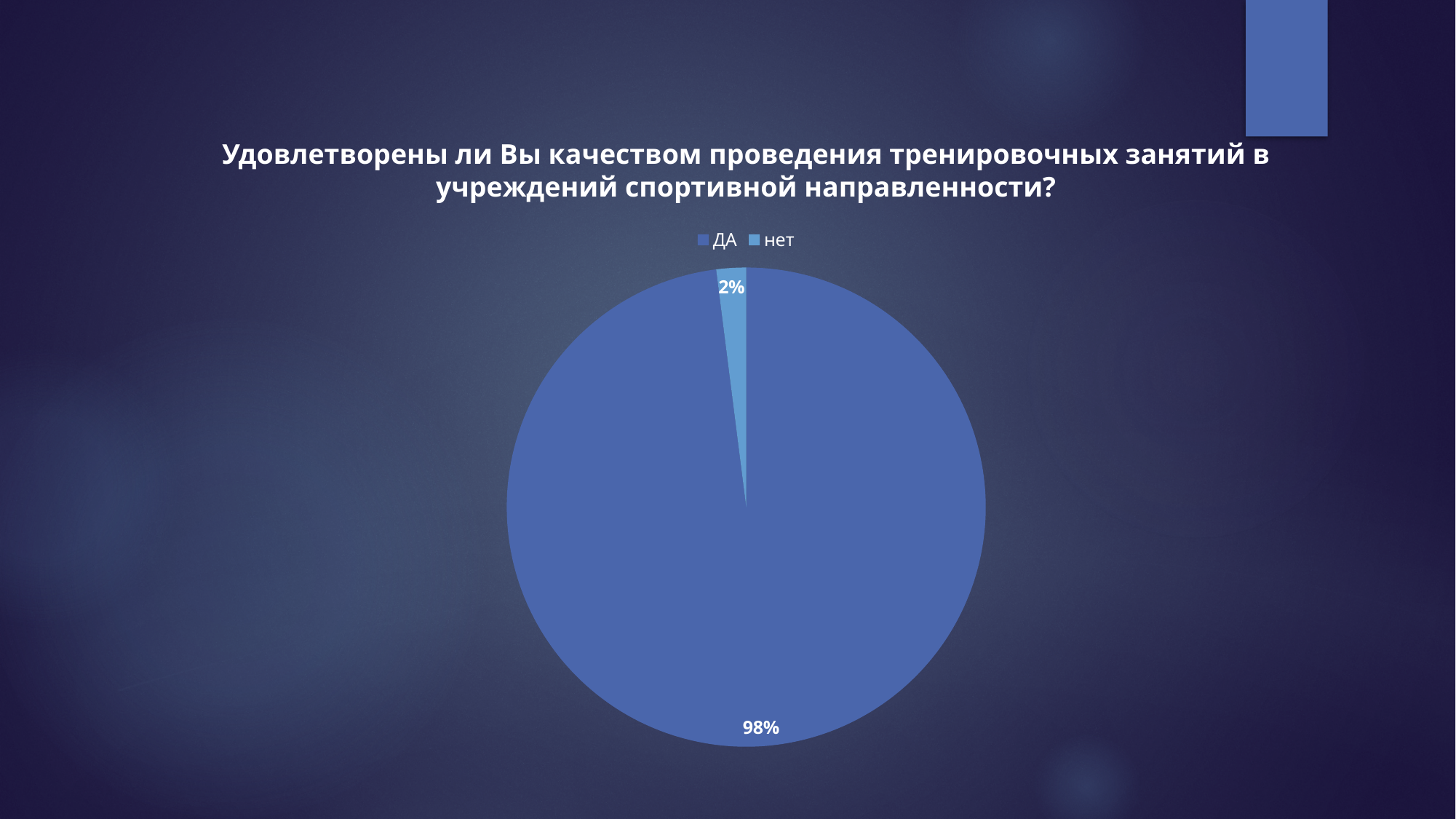
Which is larger, the "ДА" slice or the "нет" slice? ДА What is the difference in percentage points between the "ДА" and "нет" slices? 96 Which slice is the largest? ДА Which slice is the smallest? нет What kind of chart is shown on the slide? pie chart What are the two legend entries of the chart? ДА, нет How many slices does the pie chart have? 2 What is the title of the chart? Удовлетворены ли Вы качеством проведения тренировочных занятий в учреждений спортивной направленности? What share of the pie does "ДА" take? 98% How many entries does the legend list? 2 What share of the pie does "нет" take? 2%